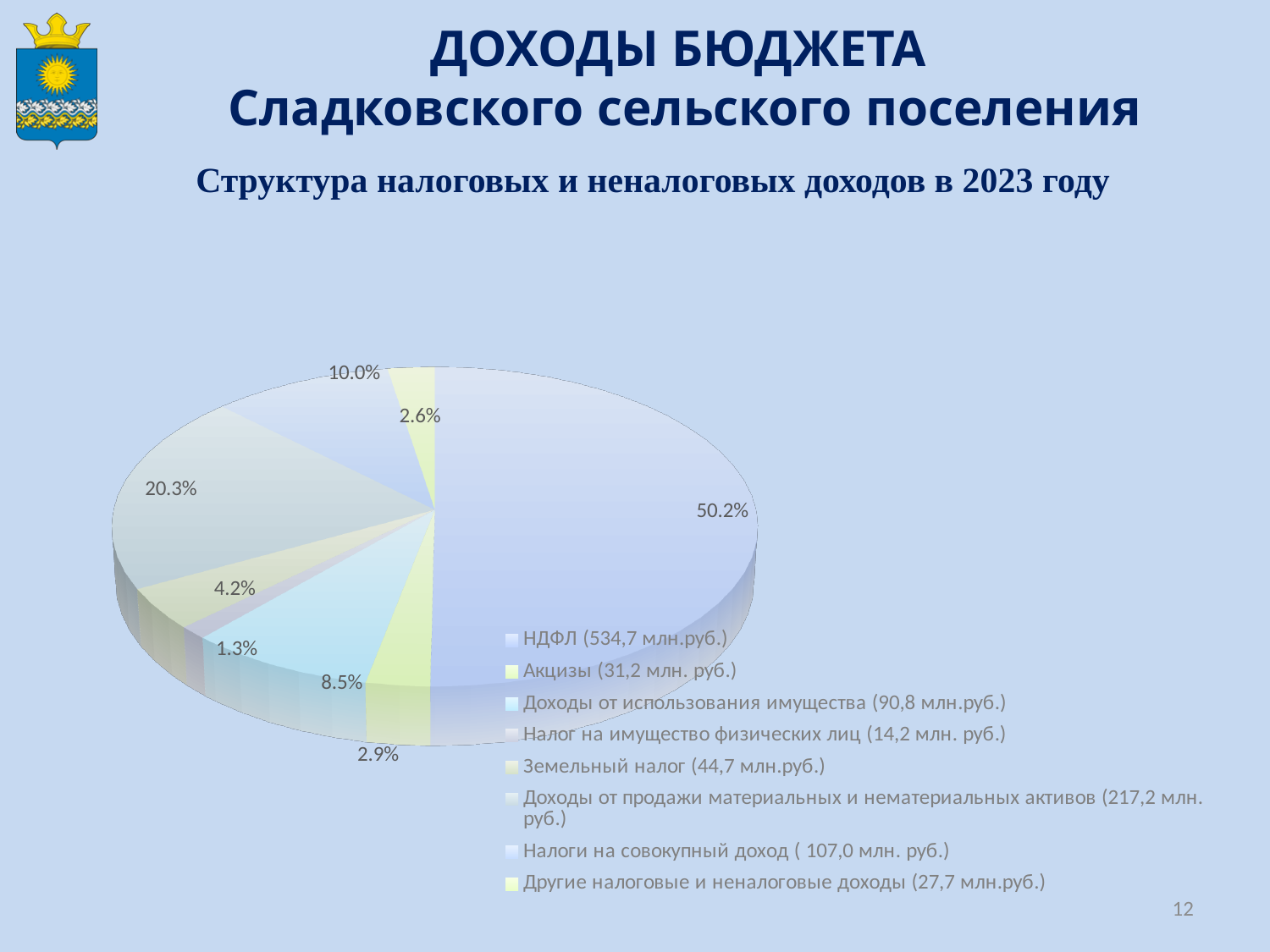
What is the title of the chart on the slide? Структура налоговых и неналоговых доходов в 2023 году What value in млн. руб. does the legend give for Доходы от использования имущества? 90,8 млн.руб. Which is larger: the share for Акцизы or the share for Другие налоговые и неналоговые доходы? Акцизы What value in млн. руб. does the legend give for Земельный налог? 44,7 млн.руб. What share of the pie does Налоги на совокупный доход account for? 10.0% What kind of chart is shown on the slide? Pie chart What share of the pie does Доходы от продажи материальных и нематериальных активов account for? 20.3% Which category has the largest slice of the pie? НДФЛ What is the difference in percentage points between the НДФЛ share and the Доходы от продажи материальных и нематериальных активов share? 29.9 percentage points Which category has the smallest slice of the pie? Налог на имущество физических лиц What share of the pie does НДФЛ account for? 50.2% How many slices does the pie chart have? 8